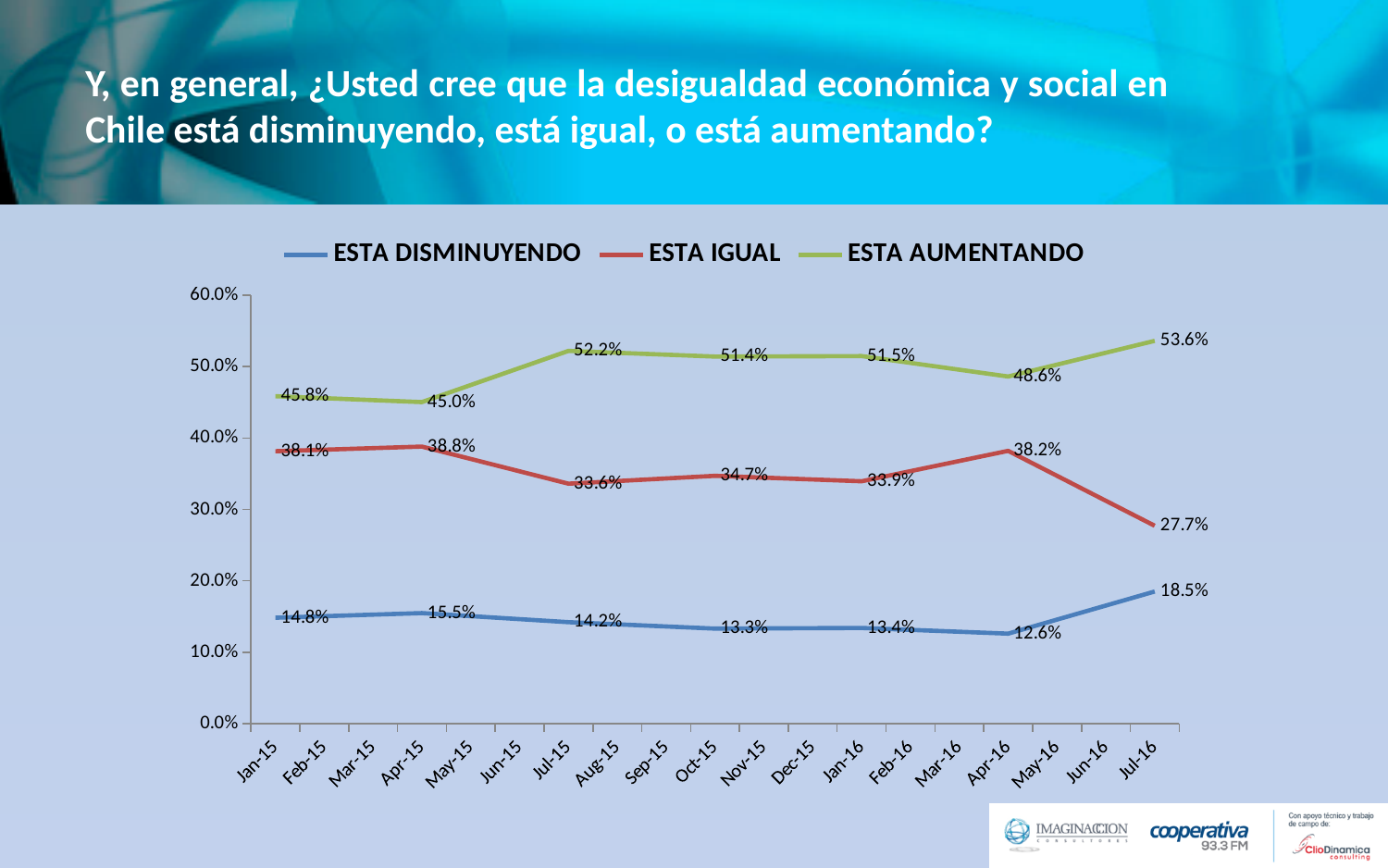
Does ESTA IGUAL rise or fall between Apr-16 and Jul-16? Fall How many data points are plotted for each series? 7 What is the value for ESTA IGUAL in Apr-16? 38.2% How many series does the legend list? 3 What kind of chart is shown on the slide? Line chart In which month does ESTA AUMENTANDO reach its highest value? Jul-16 What is the difference between ESTA IGUAL in Apr-16 and Jul-16? 10.5% Is the value for ESTA AUMENTANDO in Jan-15 greater or less than 50.0%? less What is the value for ESTA DISMINUYENDO in Jan-15? 14.8% Which is larger in Jul-15: ESTA IGUAL or ESTA DISMINUYENDO? ESTA IGUAL What is the value for ESTA AUMENTANDO in Jul-16? 53.6% In which month does ESTA DISMINUYENDO have its lowest value? Apr-16